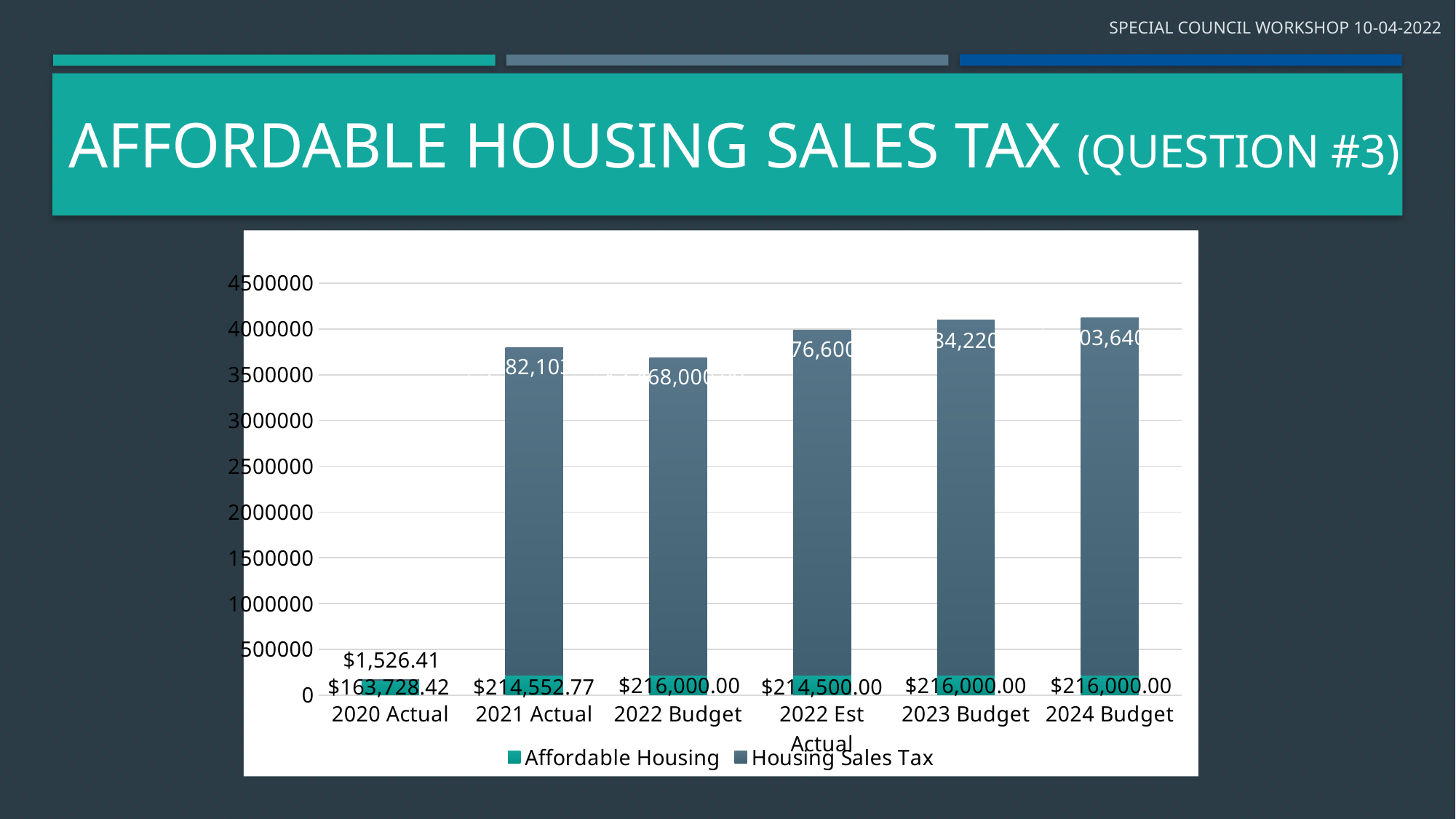
What is the Housing Sales Tax value for 2020 Actual? $1,526.41 What is the difference between the Affordable Housing values for 2022 Budget and 2022 Est Actual? $1,500.00 What kind of chart is shown on the slide? Bar chart Is the Housing Sales Tax value for 2022 Budget greater or less than 4000000? less What is the Affordable Housing value for 2021 Actual? $214,552.77 How many series does the chart's legend list? 2 Which has the larger Housing Sales Tax value, 2022 Budget or 2022 Est Actual? 2022 Est Actual What is the Affordable Housing value for 2020 Actual? $163,728.42 How many categories are shown along the x axis of the chart? 6 What is the Affordable Housing value for 2022 Est Actual? $214,500.00 Which category has the lowest Affordable Housing value? 2020 Actual Is the Housing Sales Tax value for 2021 Actual greater or less than 3500000? greater